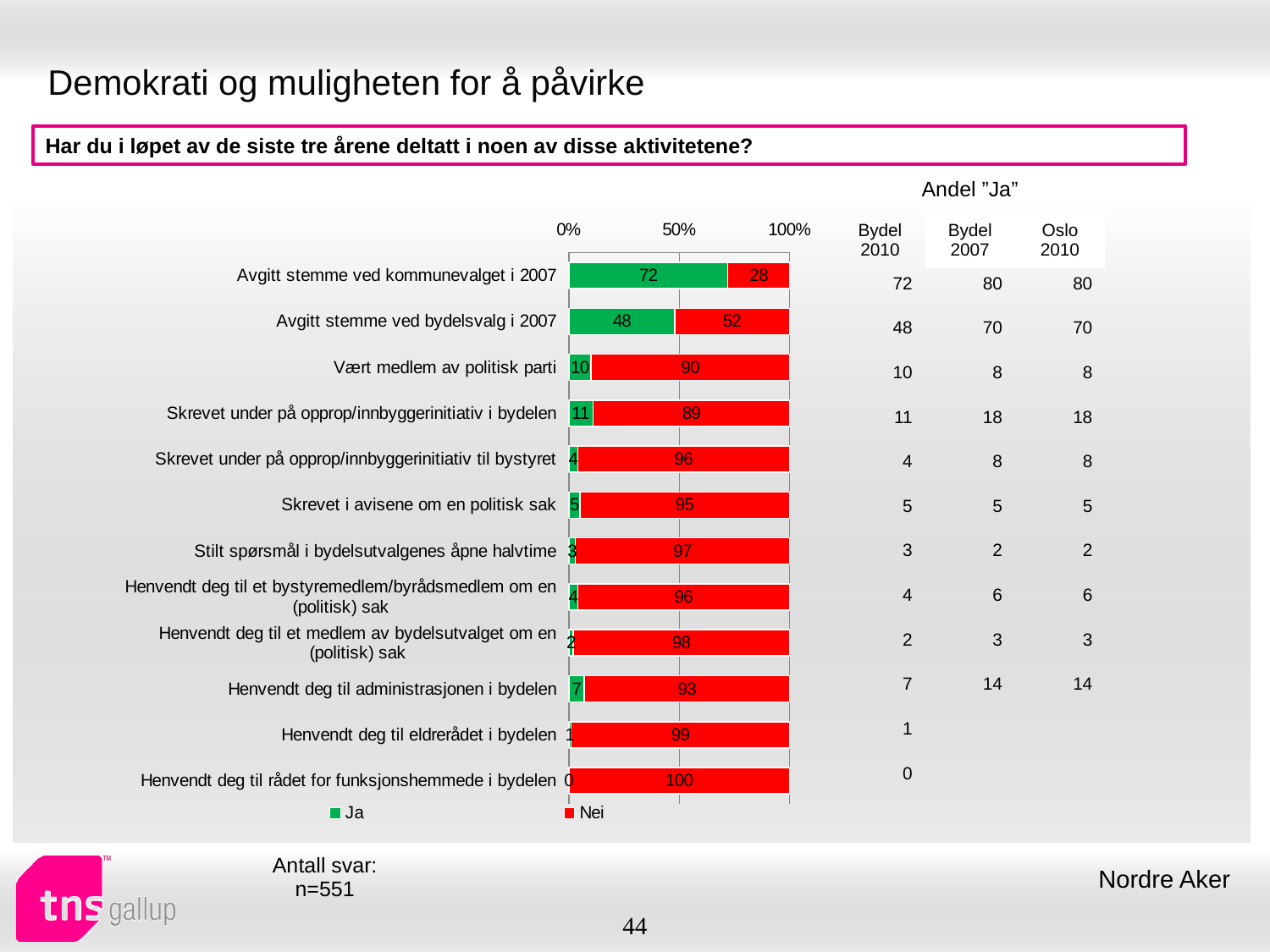
Which category has the lowest 'Ja' value? Henvendt deg til rådet for funksjonshemmede i bydelen How many categories (activities) are plotted in the chart? 12 What is the 'Nei' value for 'Avgitt stemme ved bydelsvalg i 2007'? 52 What is the total of the stacked bar for 'Henvendt deg til administrasjonen i bydelen'? 100 What is the 'Nei' value for 'Vært medlem av politisk parti'? 90 What is the difference between the 'Ja' values for 'Avgitt stemme ved kommunevalget i 2007' and 'Avgitt stemme ved bydelsvalg i 2007'? 24 Which has a larger 'Ja' value: 'Skrevet under på opprop/innbyggerinitiativ i bydelen' or 'Henvendt deg til administrasjonen i bydelen'? Skrevet under på opprop/innbyggerinitiativ i bydelen What kind of chart is shown on the slide? Stacked bar chart What is the 'Ja' value for 'Avgitt stemme ved kommunevalget i 2007'? 72 How many series does the chart legend list? 2 Which series is shown in green in the chart? Ja Which category has the highest 'Ja' value? Avgitt stemme ved kommunevalget i 2007